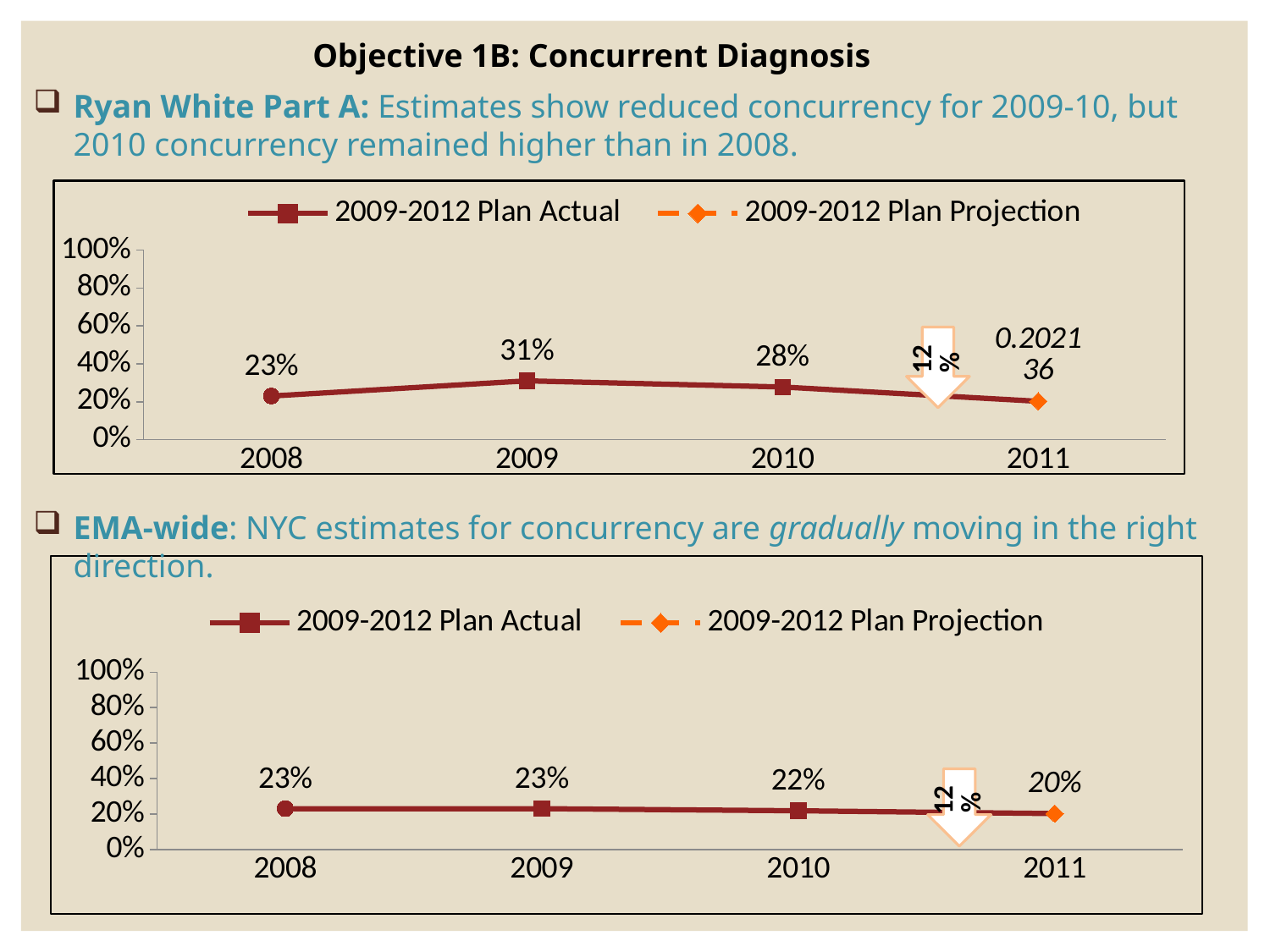
In the bottom chart (EMA-wide), what is the projected value for 2011? 20% How many years are plotted on the x axis of the bottom chart (EMA-wide)? 4 In the bottom chart (EMA-wide), do the values rise or fall from 2008 to 2011? Fall In the bottom chart (EMA-wide), what is the value for 2010? 22% In the top chart (Ryan White Part A), what is the difference between the 2009 and 2008 values? 8 percentage points In the top chart (Ryan White Part A), is the value for 2010 greater or less than the value for 2008? greater In the top chart (Ryan White Part A), what is the value for 2010? 28% What kind of chart is the bottom chart (EMA-wide)? Line chart In the bottom chart (EMA-wide), which year has the lowest value? 2011 In the top chart (Ryan White Part A), which year has the highest value? 2009 In the top chart (Ryan White Part A), what is the value for 2009? 31% How many series does the legend of the top chart list? 2